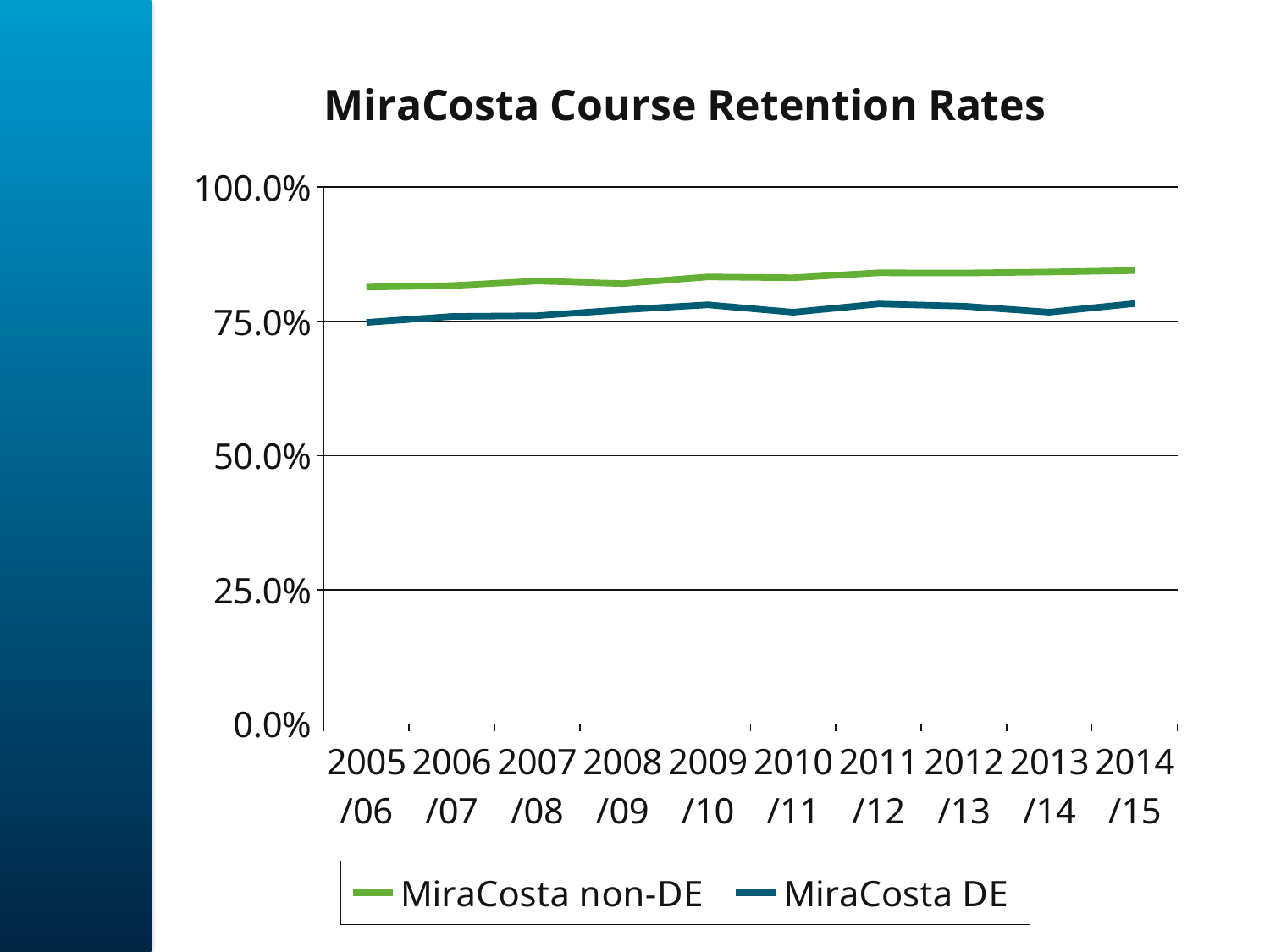
How many series does the legend list? 2 What is the title of the chart? MiraCosta Course Retention Rates Is the value for MiraCosta non-DE in 2014/15 greater or less than 100.0%? less How many academic years are plotted along the x axis? 10 What kind of chart is shown on the slide? line chart Which series is shown in green in the legend? MiraCosta non-DE Is the value for MiraCosta DE in 2011/12 greater or less than 75.0%? greater Which series has the lower value in 2005/06, MiraCosta non-DE or MiraCosta DE? MiraCosta DE Which series has the higher value in 2010/11, MiraCosta non-DE or MiraCosta DE? MiraCosta non-DE Is the value for MiraCosta DE in 2014/15 greater or less than 50.0%? greater Does the MiraCosta non-DE line generally rise or fall from 2005/06 to 2014/15? rise